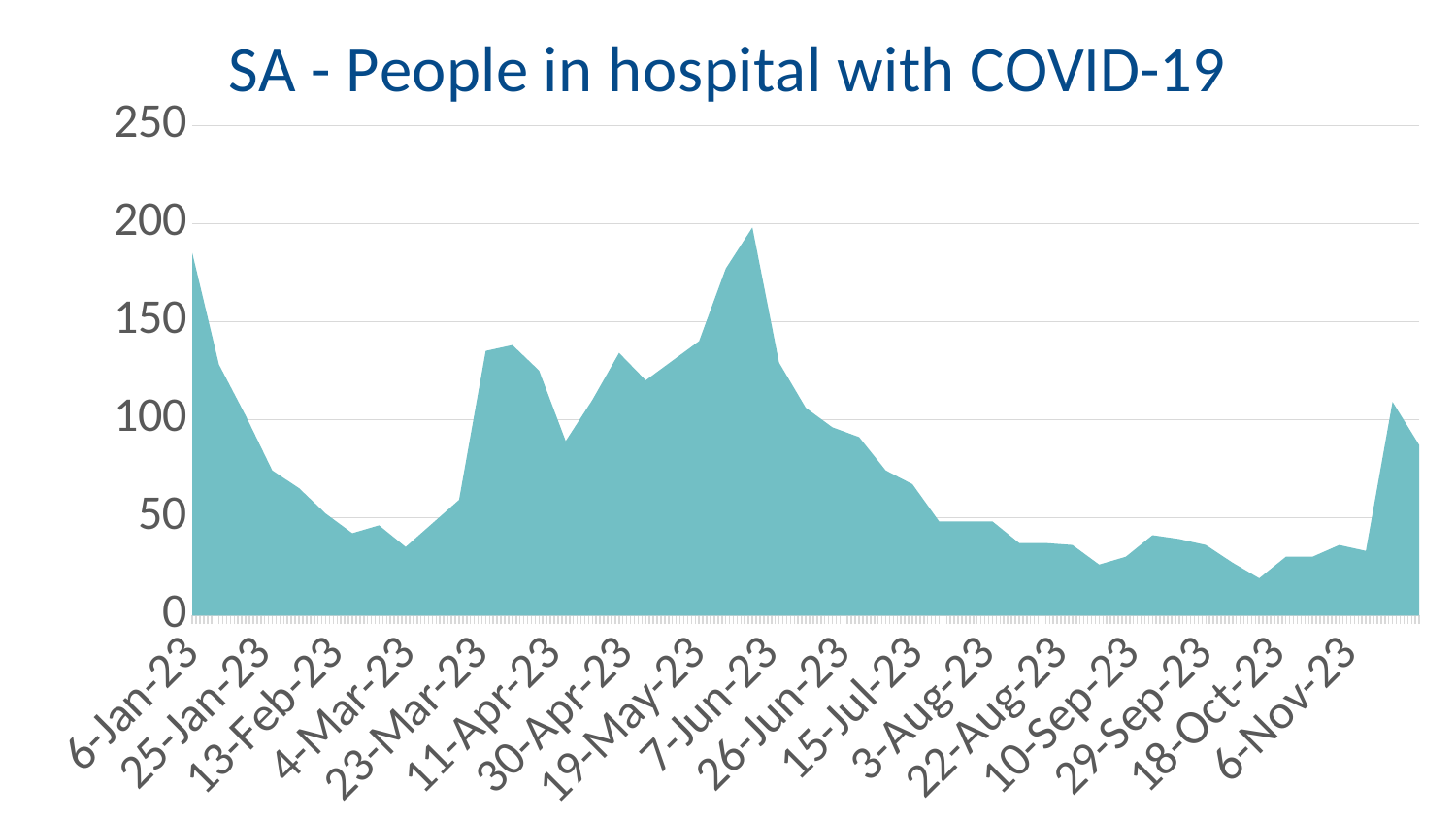
How many date labels are shown on the x axis? 17 Around which labelled date does the number of people in hospital reach its highest point? 7-Jun-23 Between 7-Jun-23 and 18-Oct-23, do the values generally rise or fall? fall Is the value for 7-Jun-23 greater or less than 150? greater Is the value for 6-Jan-23 greater or less than 150? greater Is the value for 18-Oct-23 greater or less than 50? less What is the title of the chart? SA - People in hospital with COVID-19 What kind of chart is shown on the slide? Area chart Which is larger, the value at 7-Jun-23 or the value at 6-Nov-23? 7-Jun-23